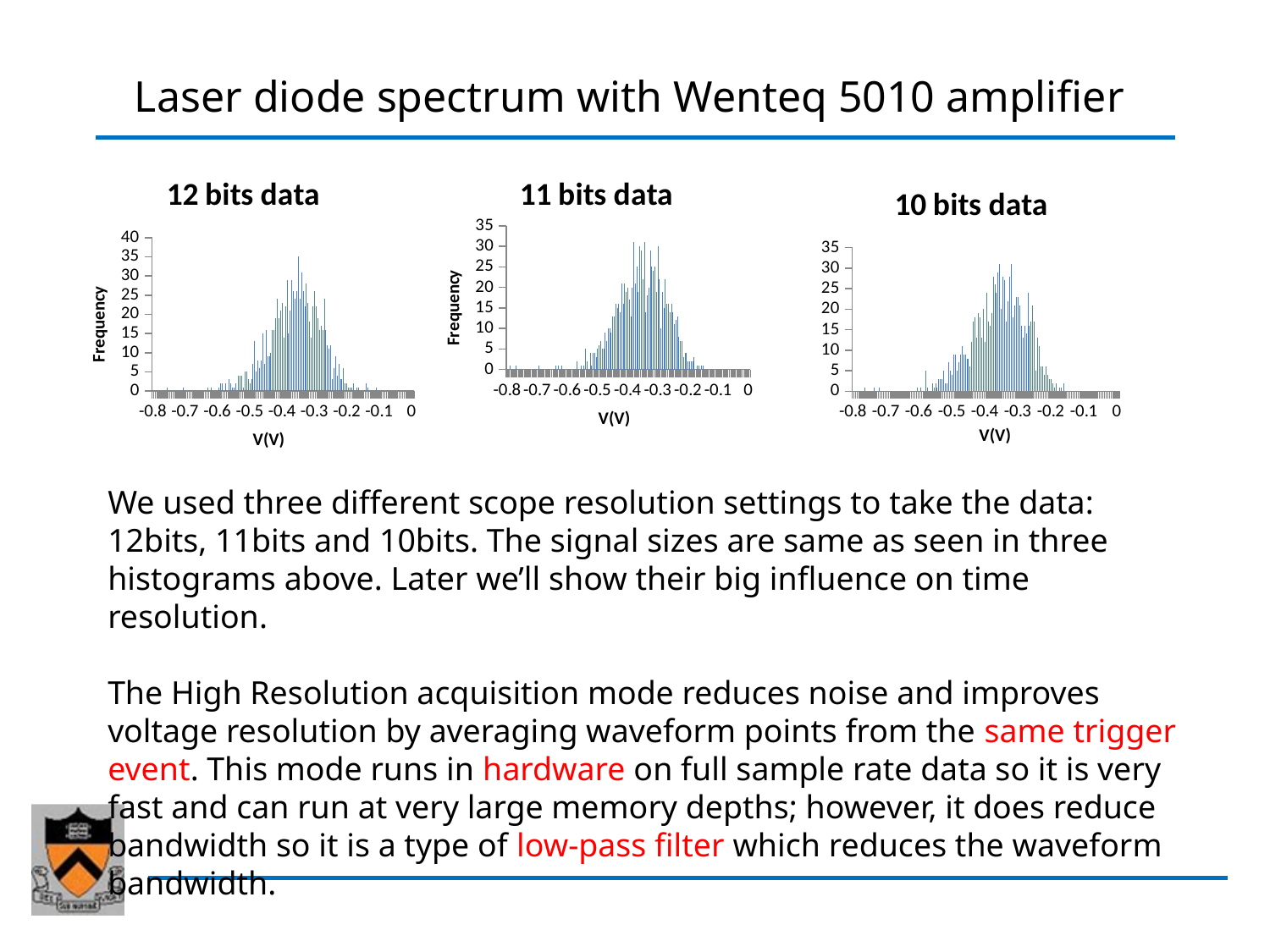
In the "12 bits data" chart, is the frequency at -0.8 V greater or less than 5? less How many charts are shown on the slide? 3 In the "10 bits data" chart, is the tallest bar greater or less than 25? greater In the "12 bits data" chart, is the tallest bar greater or less than 30? greater What is the title of the leftmost chart? 12 bits data In the "11 bits data" chart, what is the highest tick value shown on the y axis? 35 In the "12 bits data" chart, what is the highest tick value shown on the y axis? 40 What is the x-axis label on the "11 bits data" chart? V(V) What is the lowest x-axis tick value shown on the "10 bits data" chart? -0.8 What kind of chart is the "12 bits data" chart? bar chart